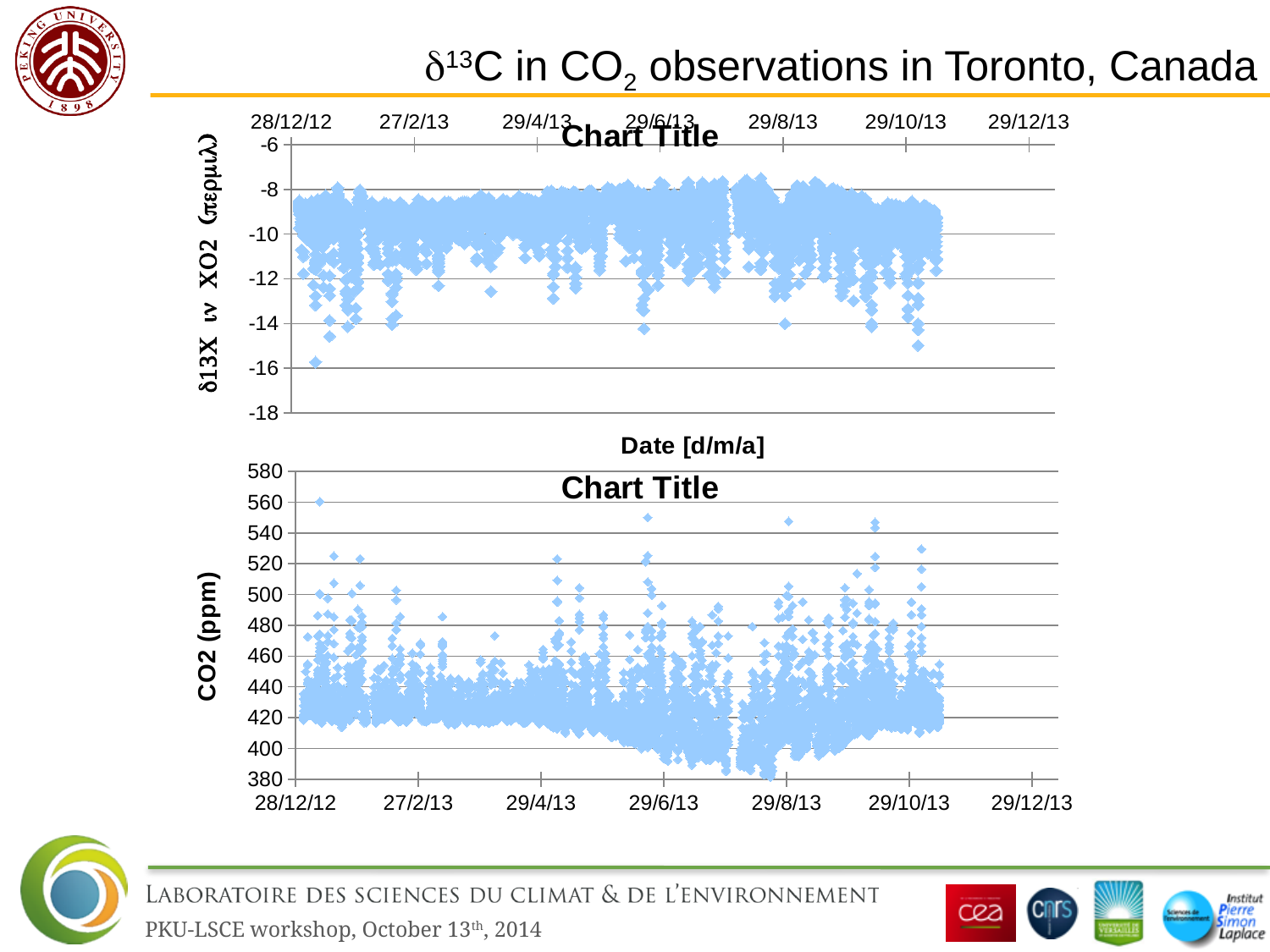
What is the y-axis label of the bottom chart? CO2 (ppm) In the bottom chart, is the highest CO2 value plotted greater or less than 540? greater What is the highest value shown on the y-axis of the bottom chart? 580 In the bottom chart, are the CO2 values around 29/6/13 to 29/8/13 mostly greater or less than 440? less What is the x-axis label shown between the two charts? Date [d/m/a] What kind of chart is the top chart on the slide? scatter chart In the top chart, is the highest δ13C value plotted greater or less than -8? greater What kind of chart is the bottom chart on the slide? scatter chart